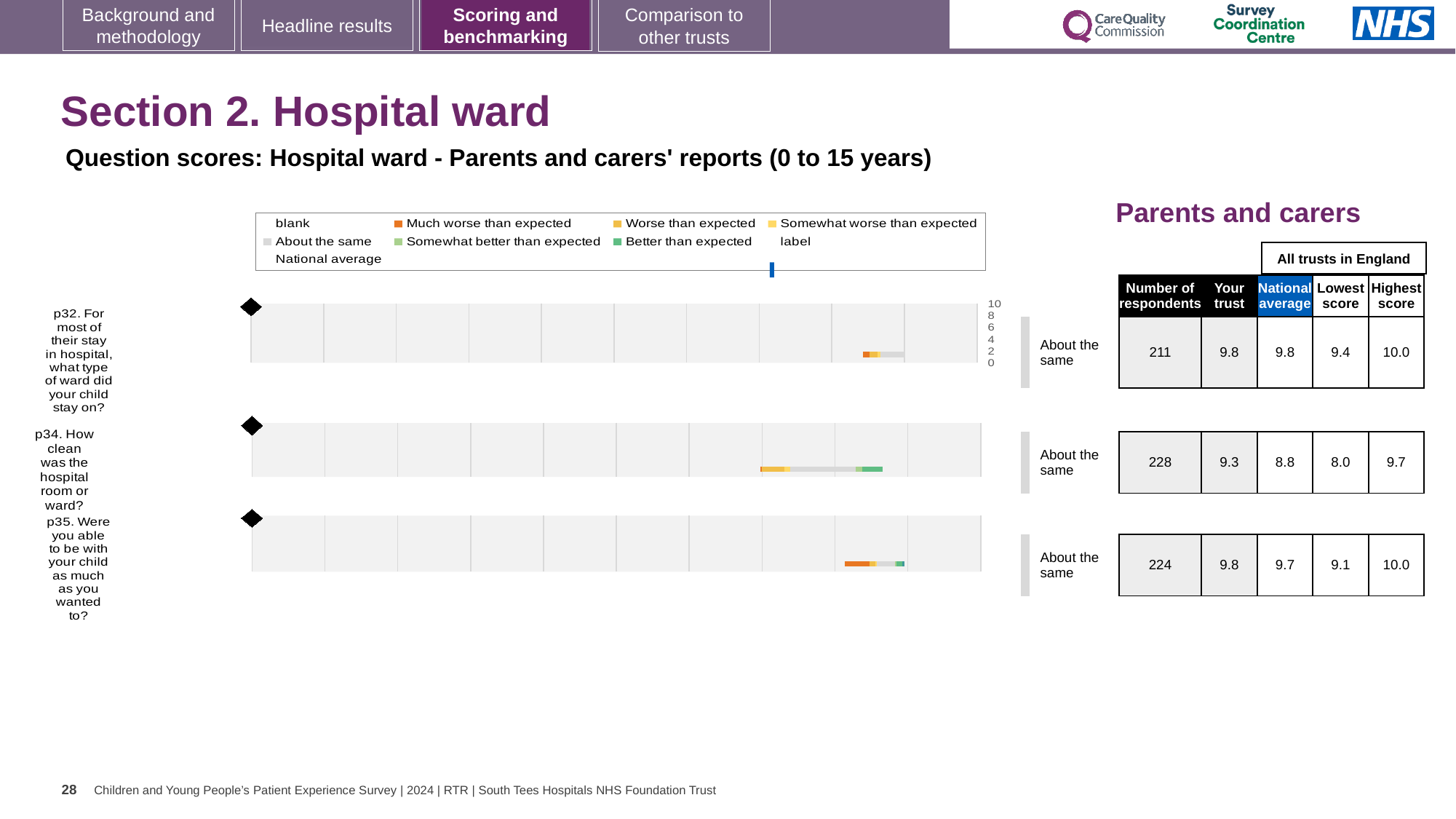
In the table beside the charts, what is the National average for p35 'Were you able to be with your child as much as you wanted to?' 9.7 In the table beside the charts, which question has the highest number of respondents? p34 According to the legend, which colour represents 'Much worse than expected'? orange In the table beside the charts, which question has the lowest 'Lowest score' value? p34 In the table beside the charts, how many respondents answered p32 'For most of their stay in hospital, what type of ward did your child stay on?' 211 For p34, which is larger: the 'Your trust' score or the National average? Your trust What benchmark category is shown next to the bar chart for p34 'How clean was the hospital room or ward?' About the same What kind of chart is used to show the benchmark results for each question on this slide? bar chart How many questions (p32, p34, p35) have a benchmark bar chart on this slide? 3 In the table beside the charts, what is the 'Your trust' score for p34 'How clean was the hospital room or ward?' 9.3 For p34, what is the difference between the 'Your trust' score and the National average? 0.5 How many entries does the legend above the bar charts list? 9